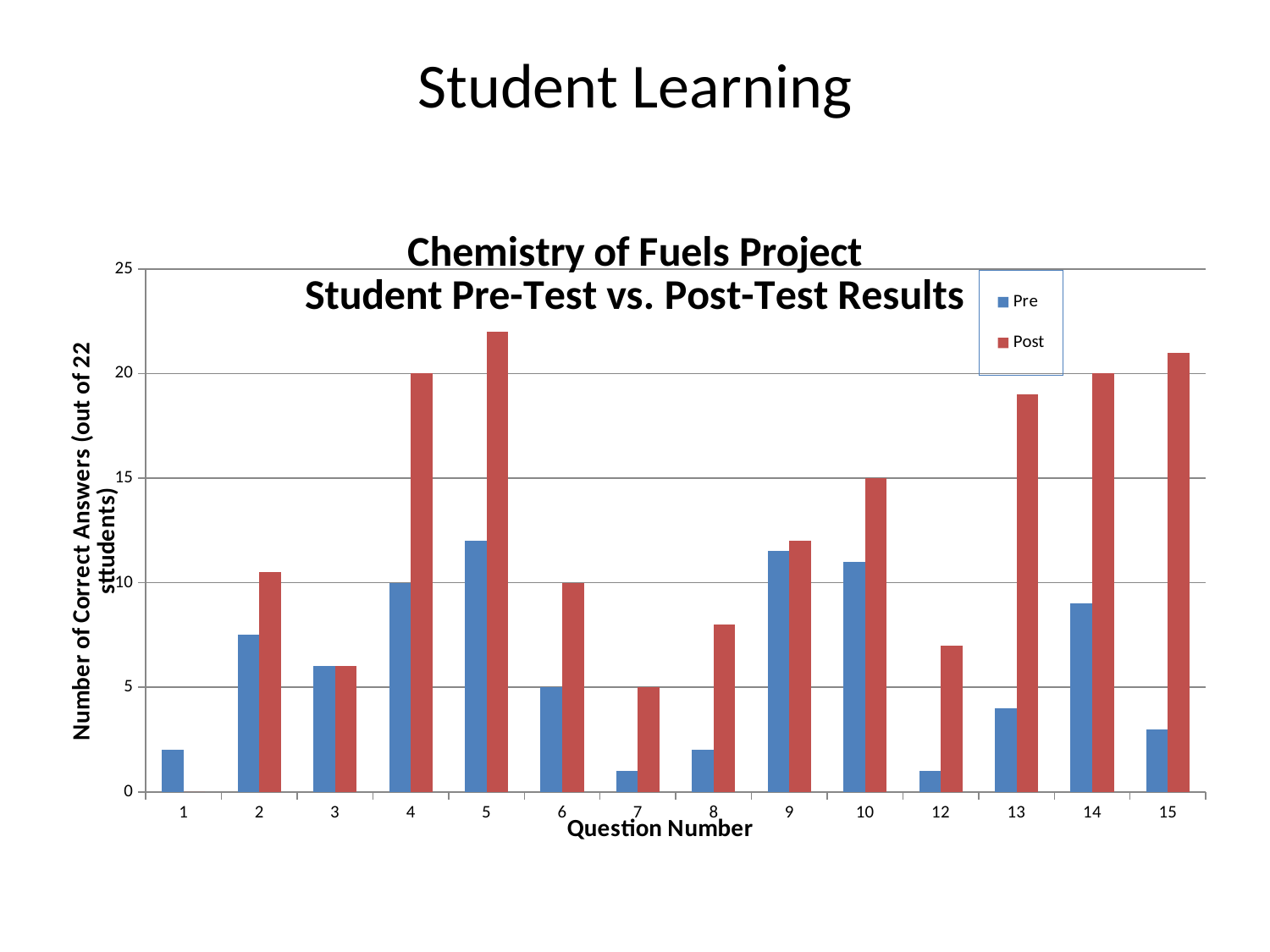
What is the Pre value for question 4? 10 What is the Post value for question 7? 5 How many question numbers are shown along the x axis? 14 How many series does the legend list? 2 What is the Post value for question 4? 20 What is the difference between the Post and Pre values for question 4? 10 What is the title of the chart? Chemistry of Fuels Project Student Pre-Test vs. Post-Test Results What is the Post value for question 10? 15 What kind of chart is shown on the slide? bar chart Is the Pre value for question 1 greater or less than 5? less Is the Post value for question 5 greater or less than 20? greater For question 14, which is larger, the Pre value or the Post value? Post